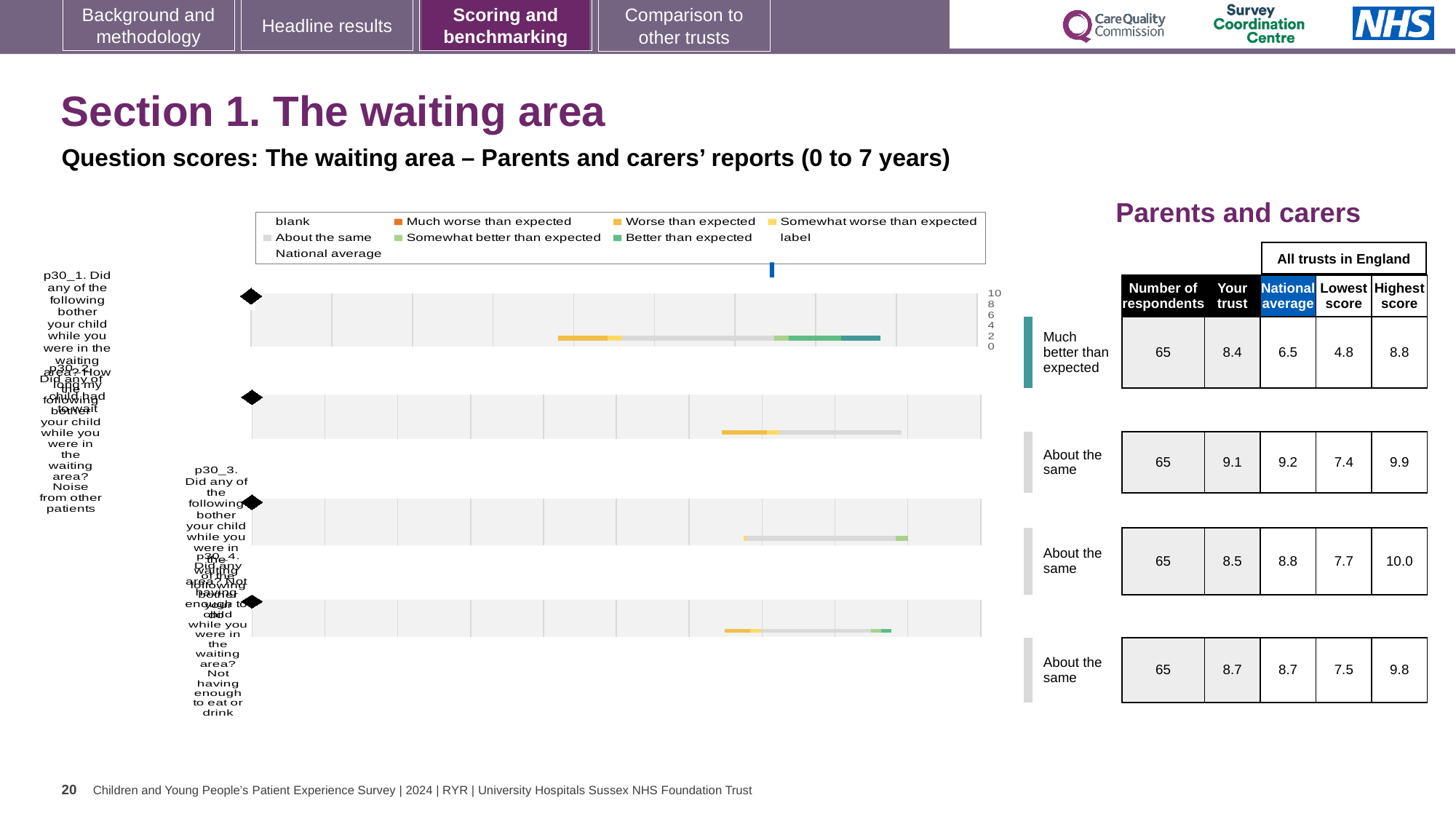
How many entries does the legend above the chart list? 9 In the table beside the charts, what is the 'Your trust' score for the second question row (noise from other patients)? 9.1 How many question rows (bars) are plotted in the waiting area chart? 4 In the table beside the charts, what is the national average for the first question row (how long my child had to wait)? 6.5 In the table beside the charts, what is the 'Your trust' score for the first question row (how long my child had to wait)? 8.4 How many respondents are listed for each question row in the table? 65 In the table beside the charts, what is the lowest score across all trusts in England for the fourth question row (not having enough to eat or drink)? 7.5 For the first question row, what is the difference between the 'Your trust' score (8.4) and the national average (6.5)? 1.9 What kind of chart is used to show the question scores on this slide? bar chart For the first question row, which is larger: the 'Your trust' score or the national average? Your trust In the table beside the charts, what is the highest score across all trusts in England for the third question row (not having enough to do)? 10.0 Which benchmark category is shown for the first question row (how long my child had to wait)? Much better than expected